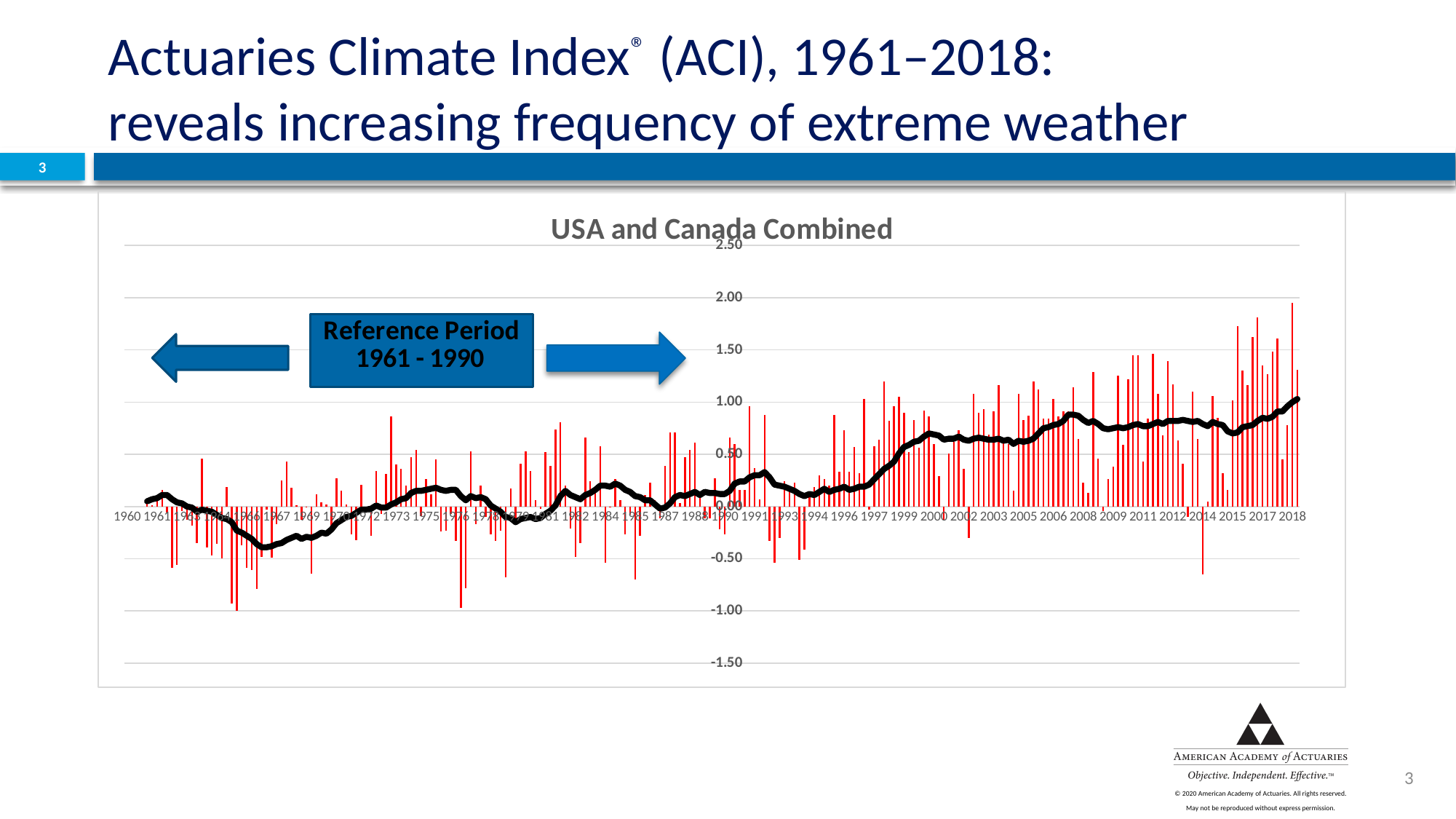
Is the value of the black line around 2008 greater or less than 0.50? greater Is the tallest red bar, near 2018, greater or less than 1.50? greater Which is larger: the black line value around 2018 or around 1966? 2018 Over the full span from 1960 to 2018, does the black smoothed line generally rise or fall? rise What is the highest value shown on the vertical axis of the chart? 2.50 What reference period is labelled on the chart? 1961 - 1990 Which is larger: the black line value around 2008 or around 1990? 2008 Is the value of the black line around 2000 greater or less than 0.50? greater What is the title of the chart on the slide? USA and Canada Combined